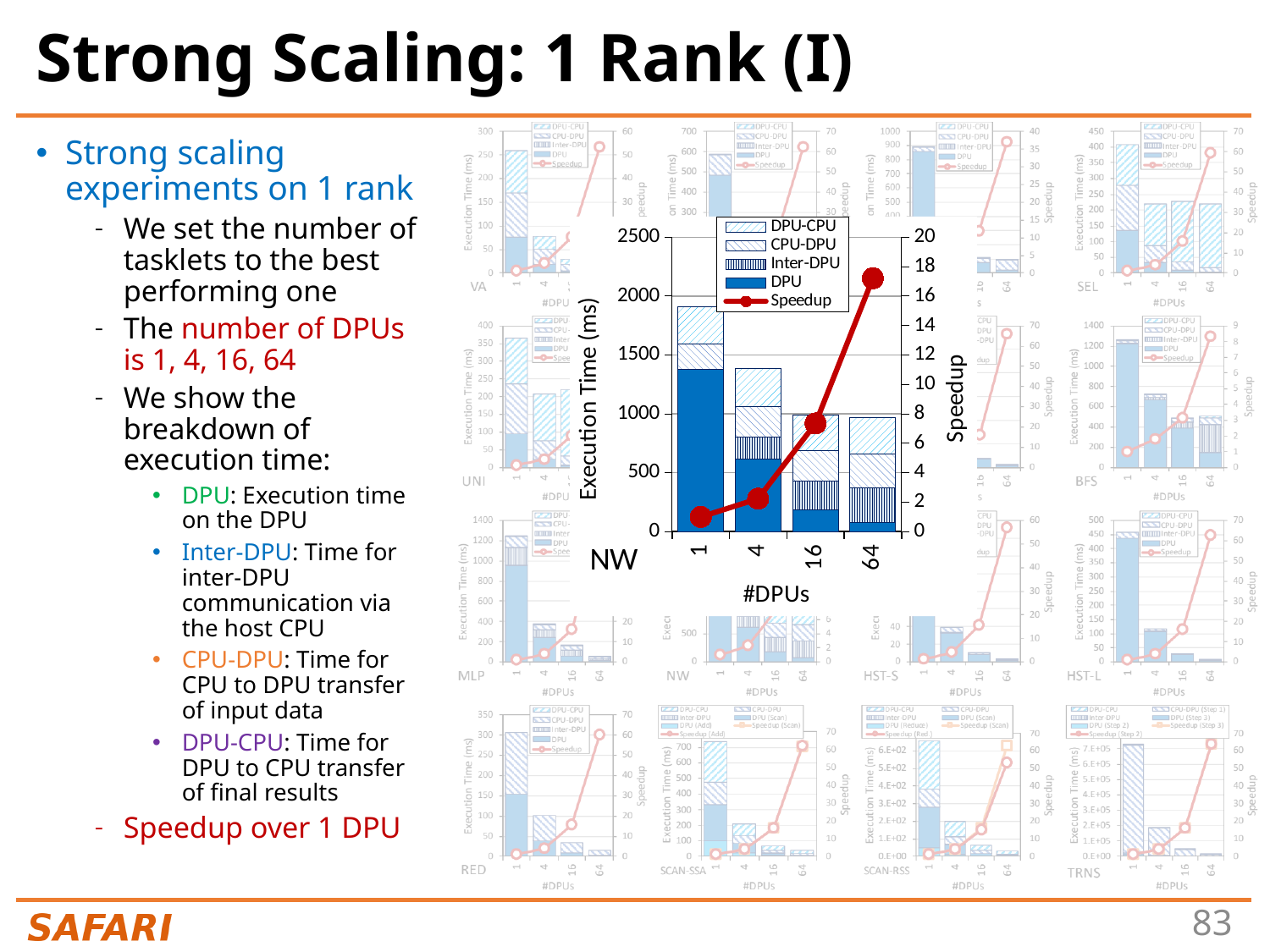
What kind of chart is the highlighted NW chart? Stacked bar chart with a line In the highlighted NW chart, what is the title of the left vertical axis? Execution Time (ms) In the highlighted NW chart, does the total execution time rise or fall as the number of DPUs increases? Fall In the highlighted NW chart, how many series does the legend list? 5 In the highlighted NW chart, at which number of DPUs is the Speedup highest? 64 In the highlighted NW chart, is the Speedup for 64 DPUs greater or less than 15? greater In the highlighted NW chart, does the Speedup line rise or fall as the number of DPUs increases? Rise In the highlighted NW chart, is the total execution time for 1 DPU greater or less than 1500 ms? greater In the highlighted NW chart, at which number of DPUs is the total execution time bar the tallest? 1 In the highlighted NW chart, is the Speedup for 4 DPUs greater or less than 5? less In the highlighted NW chart, how many #DPUs categories are shown on the x axis? 4